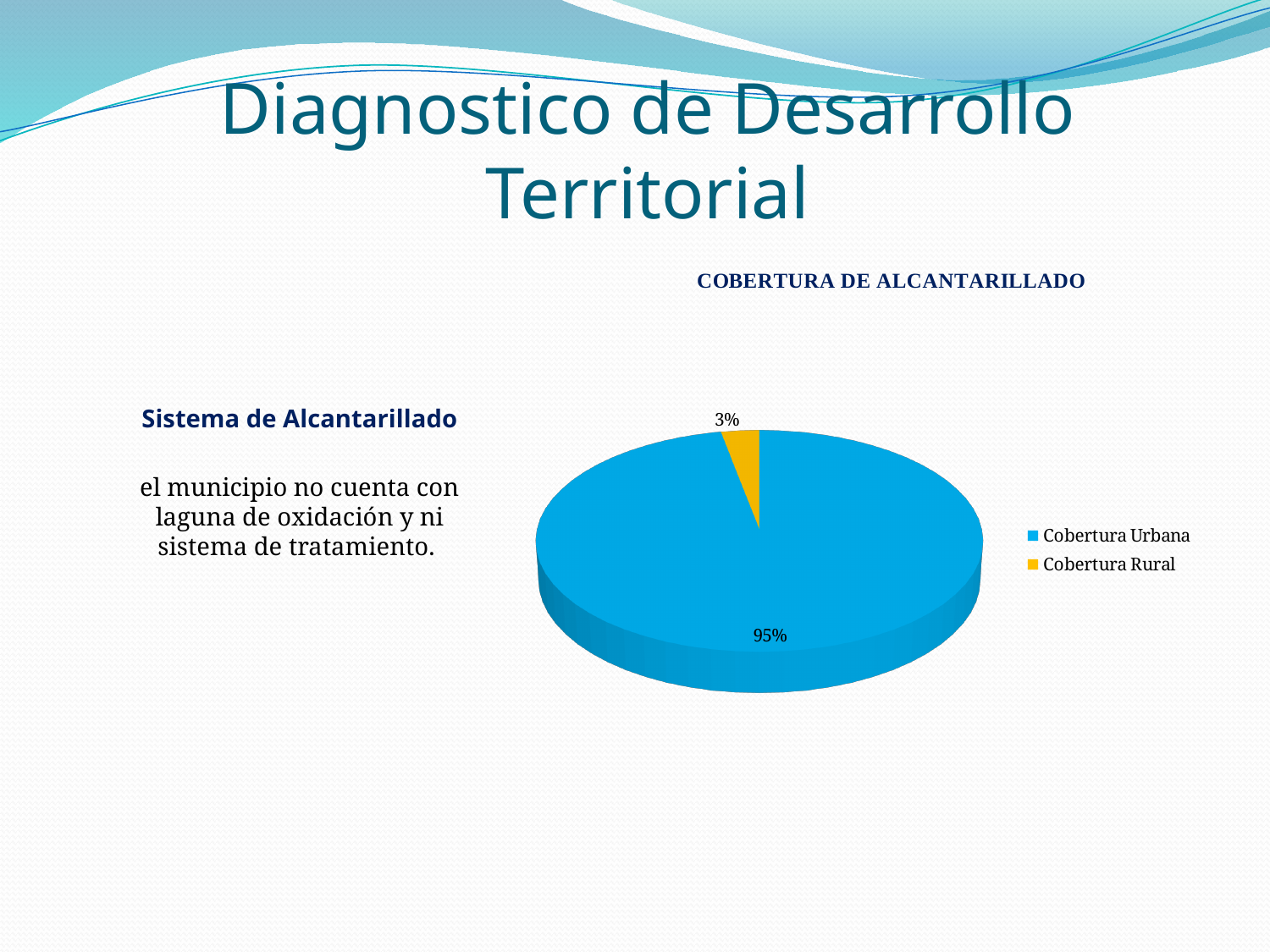
Which category has the smallest slice of the pie? Cobertura Rural What is the difference between the Cobertura Urbana and Cobertura Rural percentages? 92% Which is larger, Cobertura Urbana or Cobertura Rural? Cobertura Urbana What colour is the Cobertura Rural slice? Yellow What is the title of the chart? COBERTURA DE ALCANTARILLADO How many categories does the legend list? 2 What percentage is shown for Cobertura Rural? 3% What kind of chart is shown on the slide? Pie chart Which category has the largest slice of the pie? Cobertura Urbana What percentage is shown for Cobertura Urbana? 95%